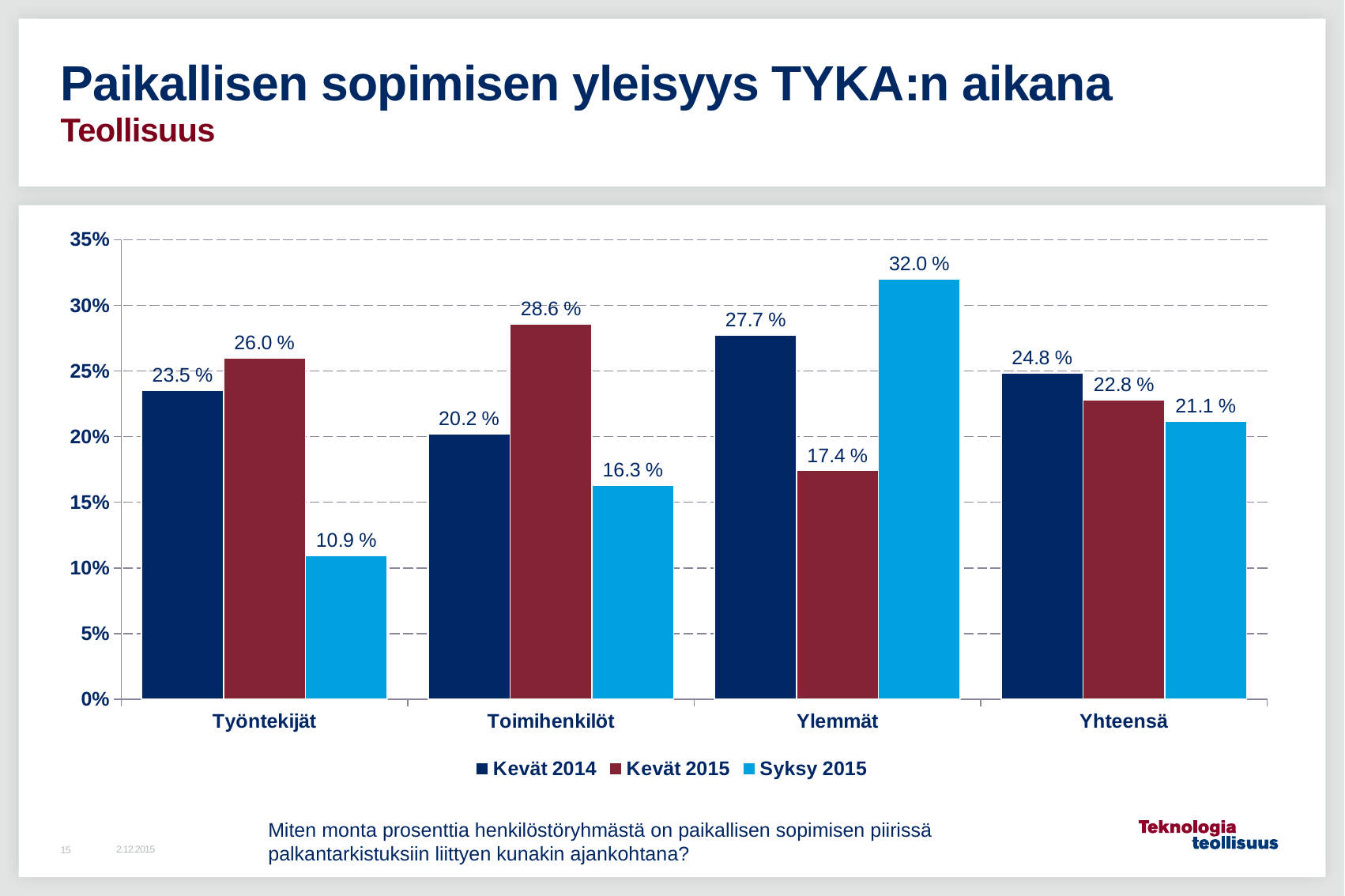
What is the value for Työntekijät in the Kevät 2014 series? 23.5 % What is the value for Yhteensä in the Syksy 2015 series? 21.1 % Which is larger for Toimihenkilöt: the Kevät 2014 value or the Kevät 2015 value? Kevät 2015 What kind of chart is shown on the slide? bar chart What is the value for Ylemmät in the Syksy 2015 series? 32.0 % Is the Syksy 2015 value for Työntekijät greater or less than 15%? less Which category has the highest value in the Syksy 2015 series? Ylemmät How many series does the legend list? 3 How many categories are shown on the x axis? 4 Which category has the lowest value in the Kevät 2015 series? Ylemmät What is the value for Toimihenkilöt in the Kevät 2015 series? 28.6 % What is the difference between the Kevät 2014 and Syksy 2015 values for Työntekijät? 12.6 %